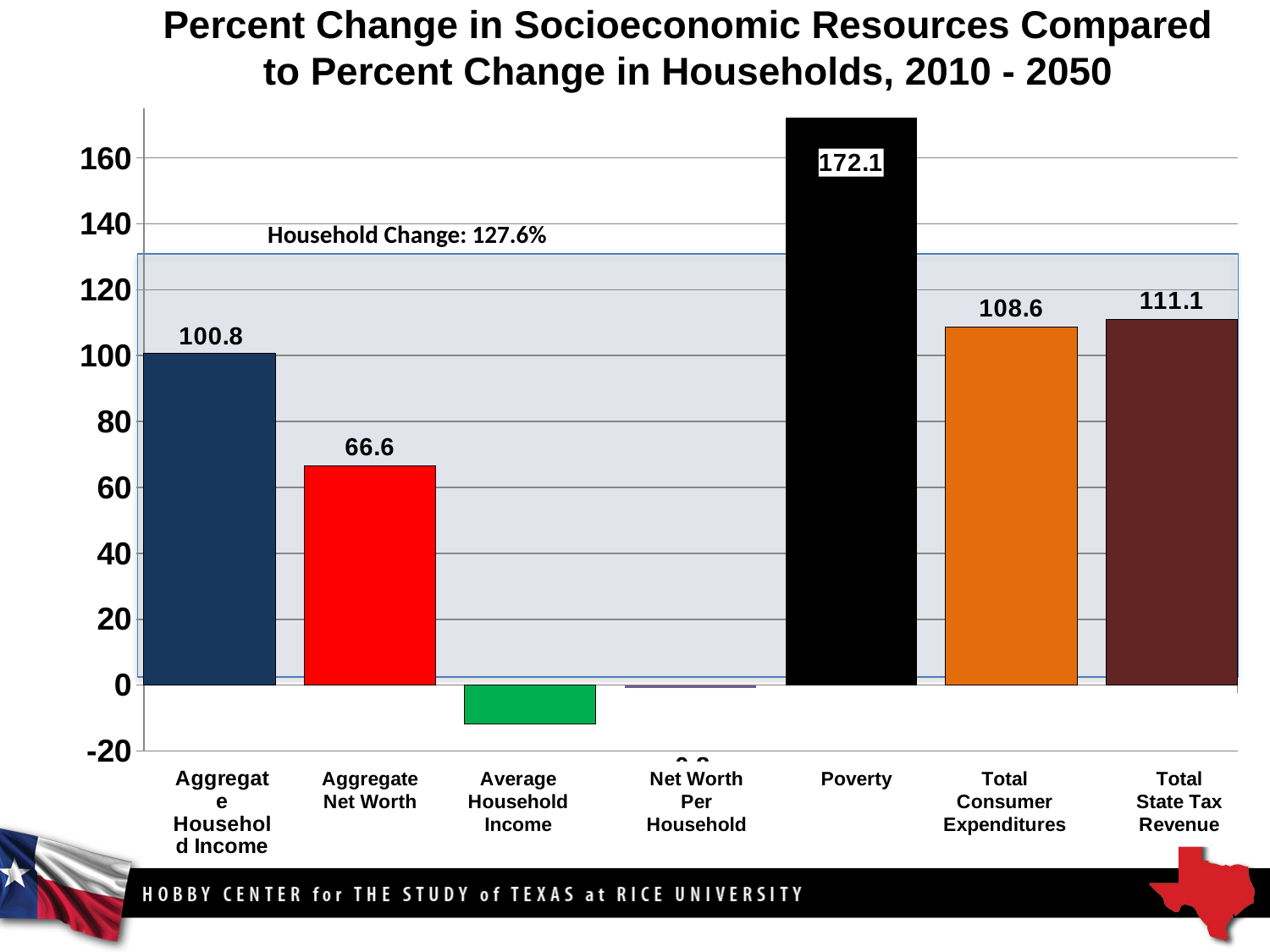
Which category has the highest value? Poverty Which category has the lowest value? Average Household Income What is the value for Aggregate Net Worth? 66.6 What is the value for Aggregate Household Income? 100.8 How many categories are shown on the x axis? 7 What is the value for Poverty? 172.1 What is the difference between the values for Total State Tax Revenue and Total Consumer Expenditures? 2.5 Is the value for Average Household Income greater or less than 0? less What kind of chart is shown on the slide? bar chart Which is larger, the value for Aggregate Household Income or the value for Aggregate Net Worth? Aggregate Household Income What Household Change percentage is noted on the chart? 127.6% What is the value for Total State Tax Revenue? 111.1